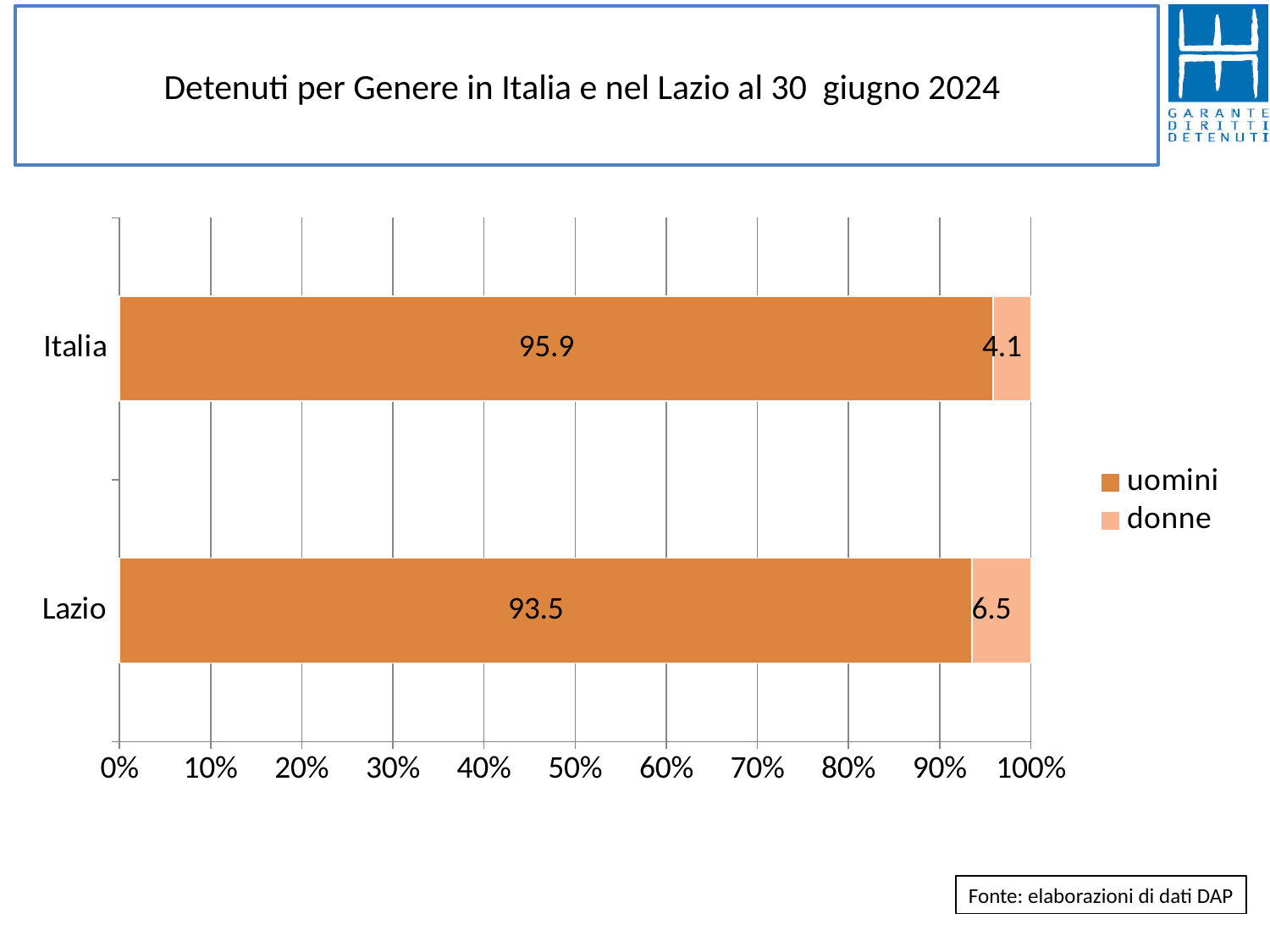
How many series does the legend list? 2 How many categories are shown on the chart? 2 What is the value for uomini in Italia? 95.9 What is the value for uomini in Lazio? 93.5 What is the difference between the uomini values for Italia and Lazio? 2.4 Which category has the lowest value for uomini? Lazio What kind of chart is shown on the slide? Stacked bar chart What is the value for donne in Lazio? 6.5 What is the total of the stacked bar for Lazio? 100 Is the value for uomini in Lazio greater or less than 90%? greater Which category has the higher value for donne, Italia or Lazio? Lazio What is the value for donne in Italia? 4.1